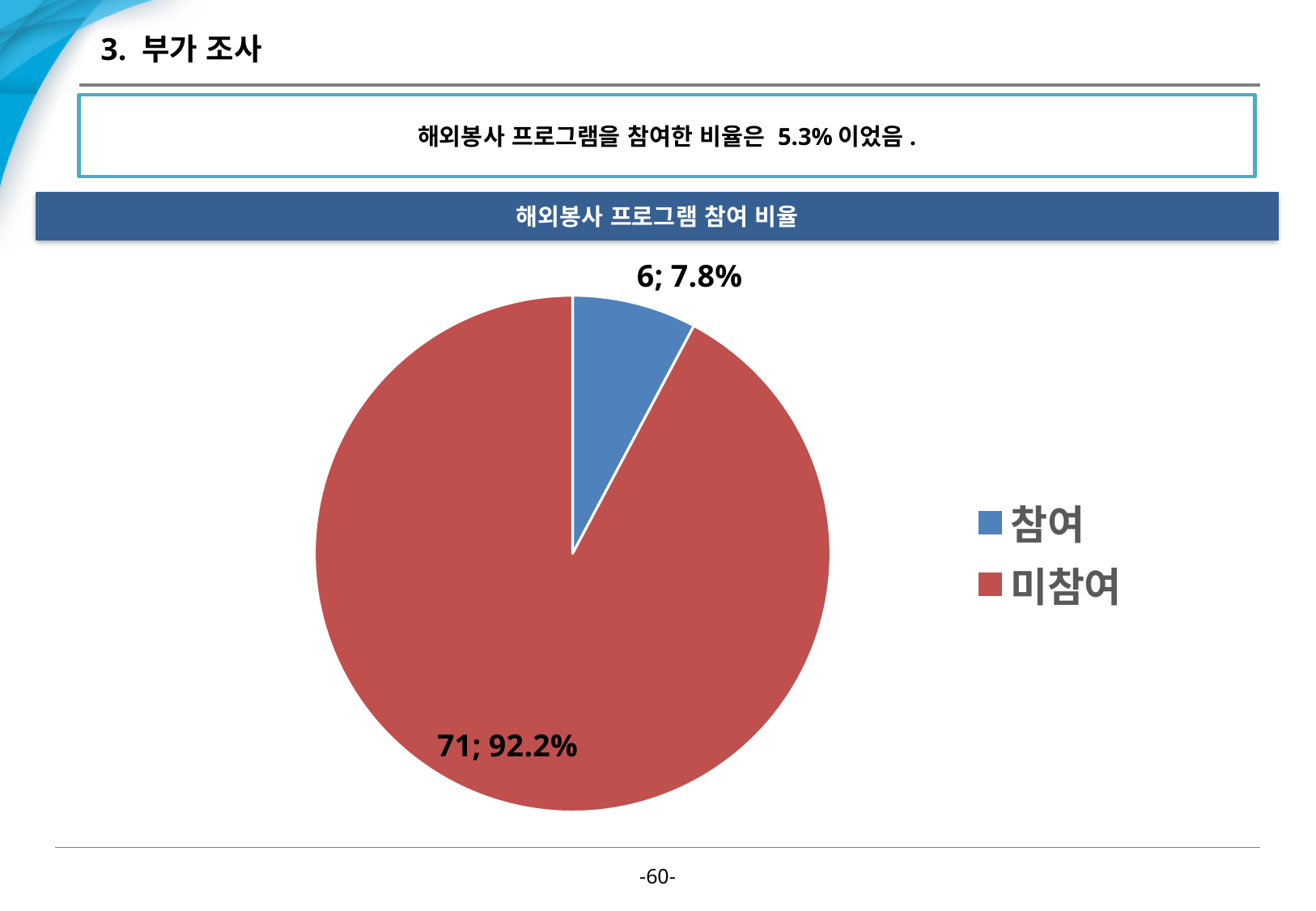
What is the total count across both slices of the pie chart? 77 How many categories does the pie chart have? 2 Which is larger, the count for 참여 or the count for 미참여? 미참여 Which category has the largest slice in the pie chart? 미참여 What is the difference between the counts for 미참여 and 참여? 65 What percentage of the pie does 참여 represent? 7.8% What percentage of the pie does 미참여 represent? 92.2% What is the count shown for 미참여 in the pie chart? 71 Which category has the smallest slice in the pie chart? 참여 What kind of chart is shown on the slide? pie chart What is the title of the chart? 해외봉사 프로그램 참여 비율 What is the count shown for 참여 in the pie chart? 6